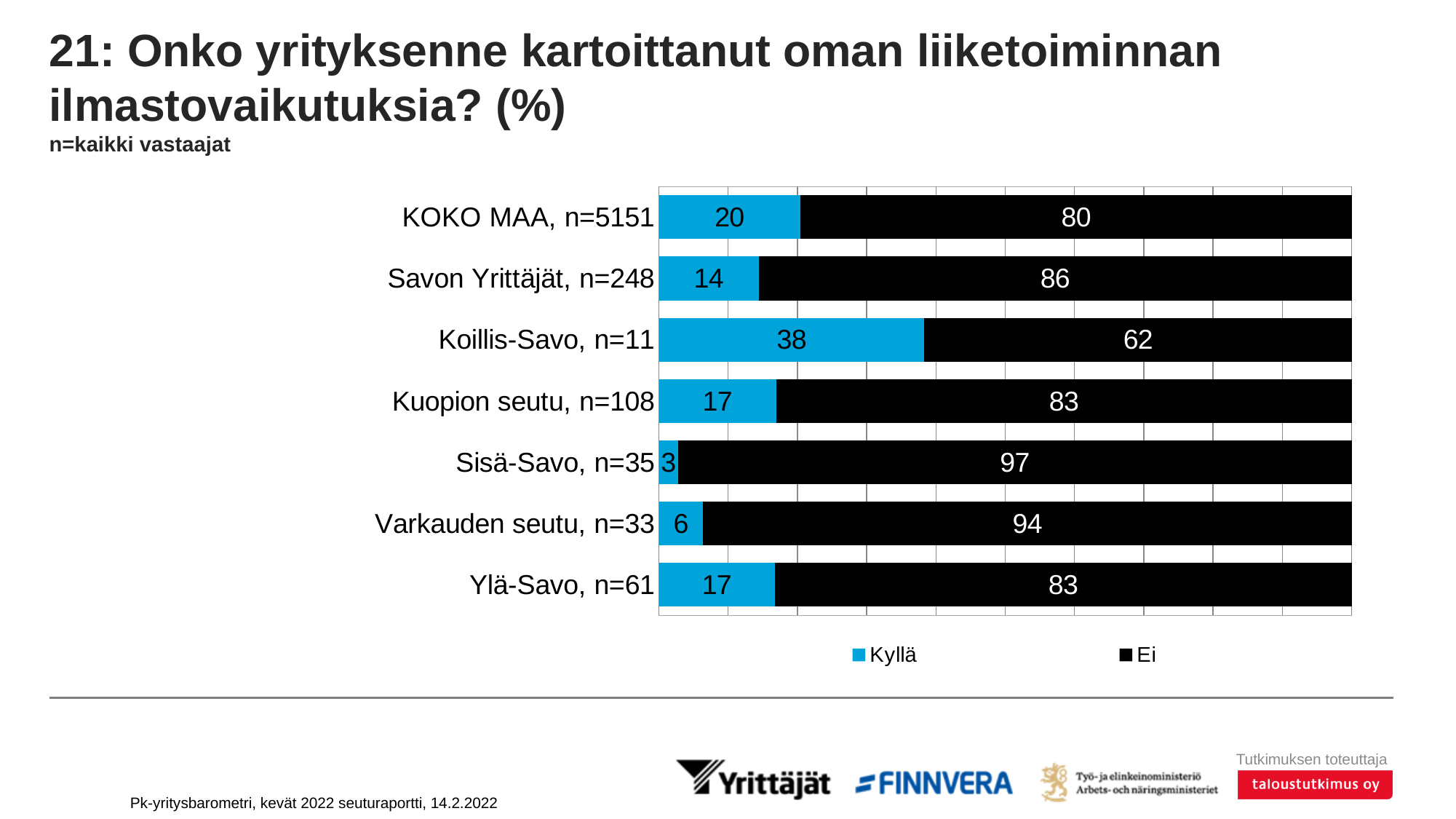
How many categories are shown in the chart? 7 Which category has the lowest Kyllä value? Sisä-Savo, n=35 Which category has the highest Kyllä value? Koillis-Savo, n=11 Which has a larger Kyllä value, Varkauden seutu, n=33 or Kuopion seutu, n=108? Kuopion seutu, n=108 How many series does the legend list? 2 What is the Kyllä value for KOKO MAA, n=5151? 20 What is the Kyllä value for Koillis-Savo, n=11? 38 What is the difference between the Ei values for Savon Yrittäjät, n=248 and KOKO MAA, n=5151? 6 Which series is shown in blue in the legend? Kyllä What is the total of the stacked bar for Ylä-Savo, n=61? 100 What is the Ei value for Sisä-Savo, n=35? 97 What kind of chart is shown on the slide? Stacked bar chart